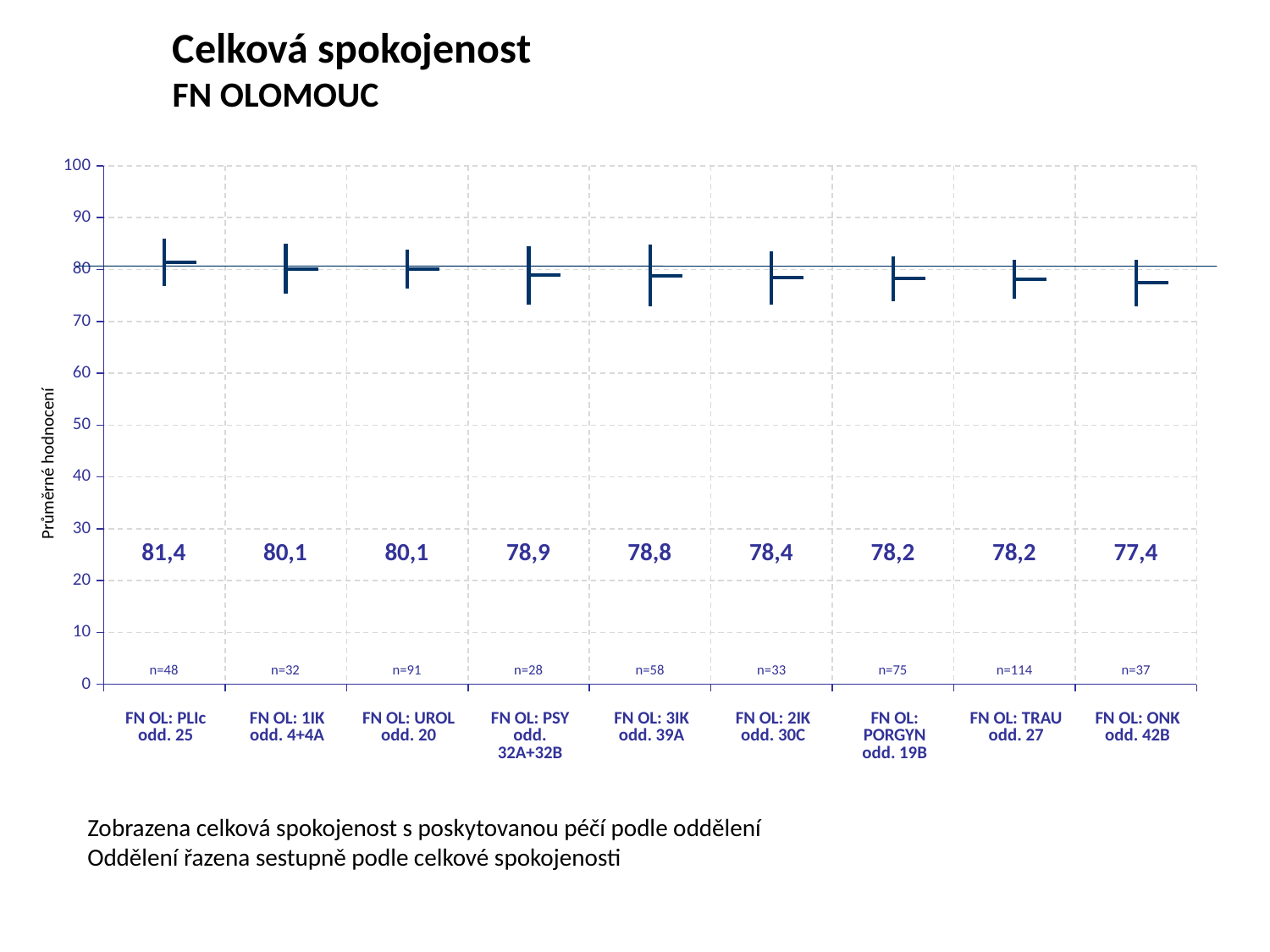
How many departments are shown on the x axis? 9 What is the value for FN OL: PLIc odd. 25? 81,4 What is the value for FN OL: ONK odd. 42B? 77,4 What is the label of the y axis? Průměrné hodnocení Is the value for FN OL: 2IK odd. 30C greater or less than 70? greater Which department has the highest value? FN OL: PLIc odd. 25 What is the value for FN OL: PORGYN odd. 19B? 78,2 Do the values rise or fall from left to right along the x axis? fall What is the n value shown for FN OL: TRAU odd. 27? n=114 Which has the larger value, FN OL: PSY odd. 32A+32B or FN OL: 3IK odd. 39A? FN OL: PSY odd. 32A+32B Which department has the lowest value? FN OL: ONK odd. 42B What is the difference between the values for FN OL: PLIc odd. 25 and FN OL: ONK odd. 42B? 4,0